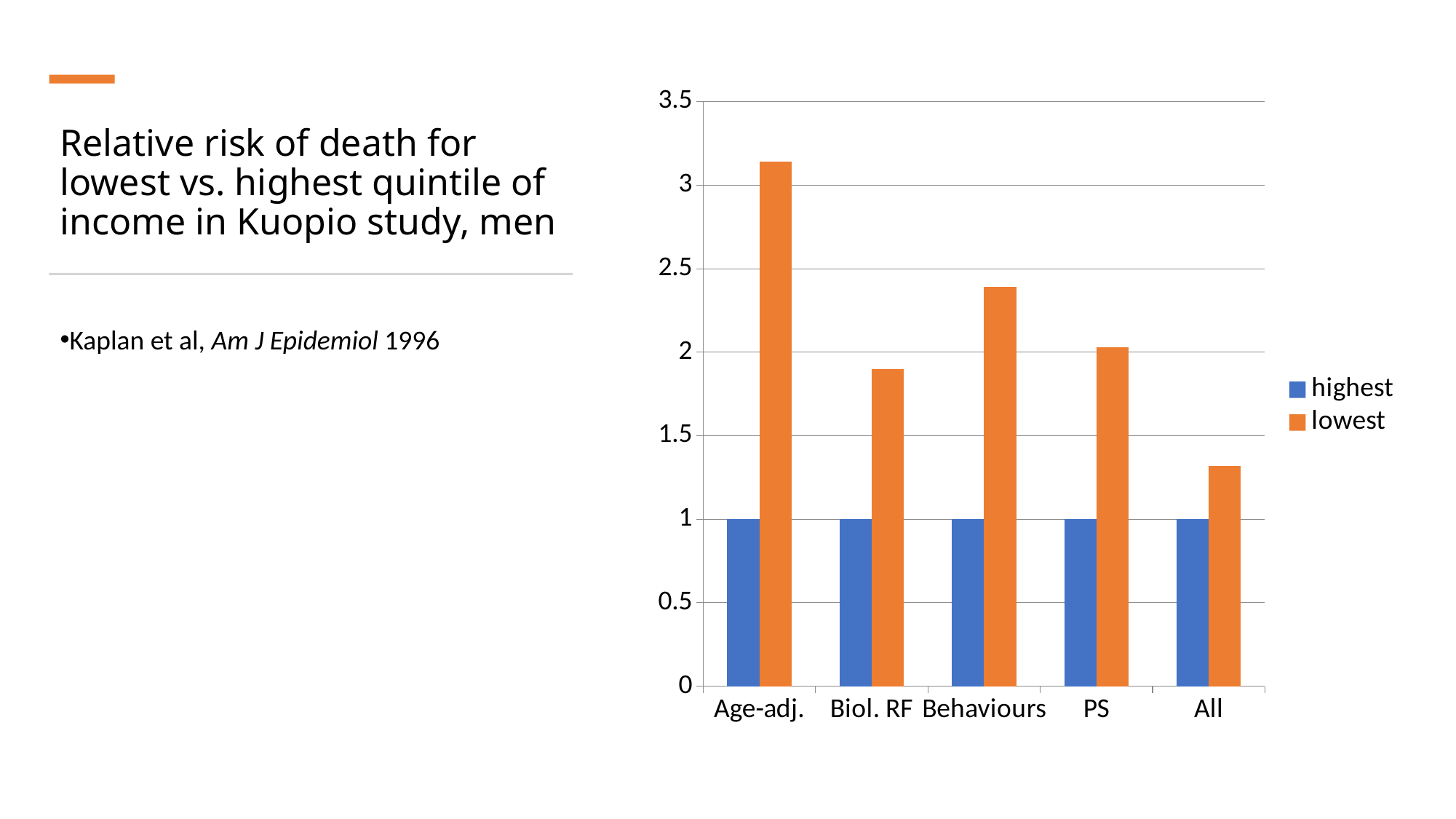
What is the value of the 'highest' series for Age-adj.? 1 How many categories are shown on the x axis? 5 Is the 'lowest' value for Behaviours greater or less than 2? greater How many series does the legend list? 2 Is the 'lowest' value for All greater or less than 1.5? less Is the 'lowest' value for Biol. RF greater or less than 2? less What is the value of the 'highest' series for All? 1 Which category has the highest value for the 'lowest' series? Age-adj. Which category has the lowest value for the 'lowest' series? All Which is larger: the 'lowest' value for Behaviours or for PS? Behaviours What kind of chart is shown on the slide? bar chart